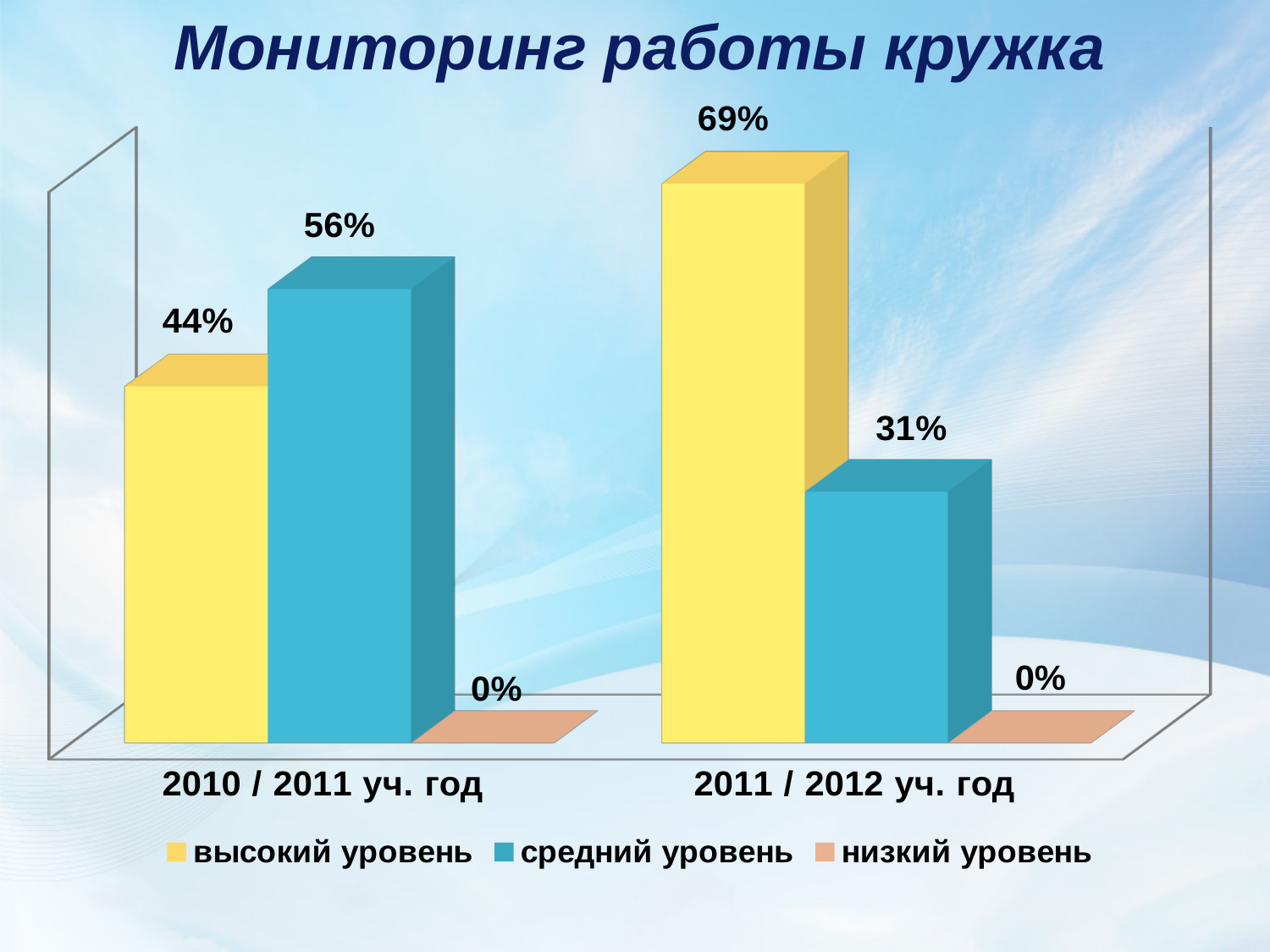
Which series has the lowest value in 2010 / 2011 уч. год? низкий уровень What is the title of the chart? Мониторинг работы кружка Which is larger in 2010 / 2011 уч. год: высокий уровень or средний уровень? средний уровень What kind of chart is shown on the slide? bar chart Which series has the highest value in 2011 / 2012 уч. год? высокий уровень What is the value for высокий уровень in 2010 / 2011 уч. год? 44% What is the value for средний уровень in 2011 / 2012 уч. год? 31% How many categories are shown on the x axis? 2 What is the value for низкий уровень in 2010 / 2011 уч. год? 0% How many series does the legend list? 3 What is the difference between высокий уровень in 2011 / 2012 уч. год and in 2010 / 2011 уч. год? 25% Does the value for средний уровень rise or fall from 2010 / 2011 уч. год to 2011 / 2012 уч. год? fall